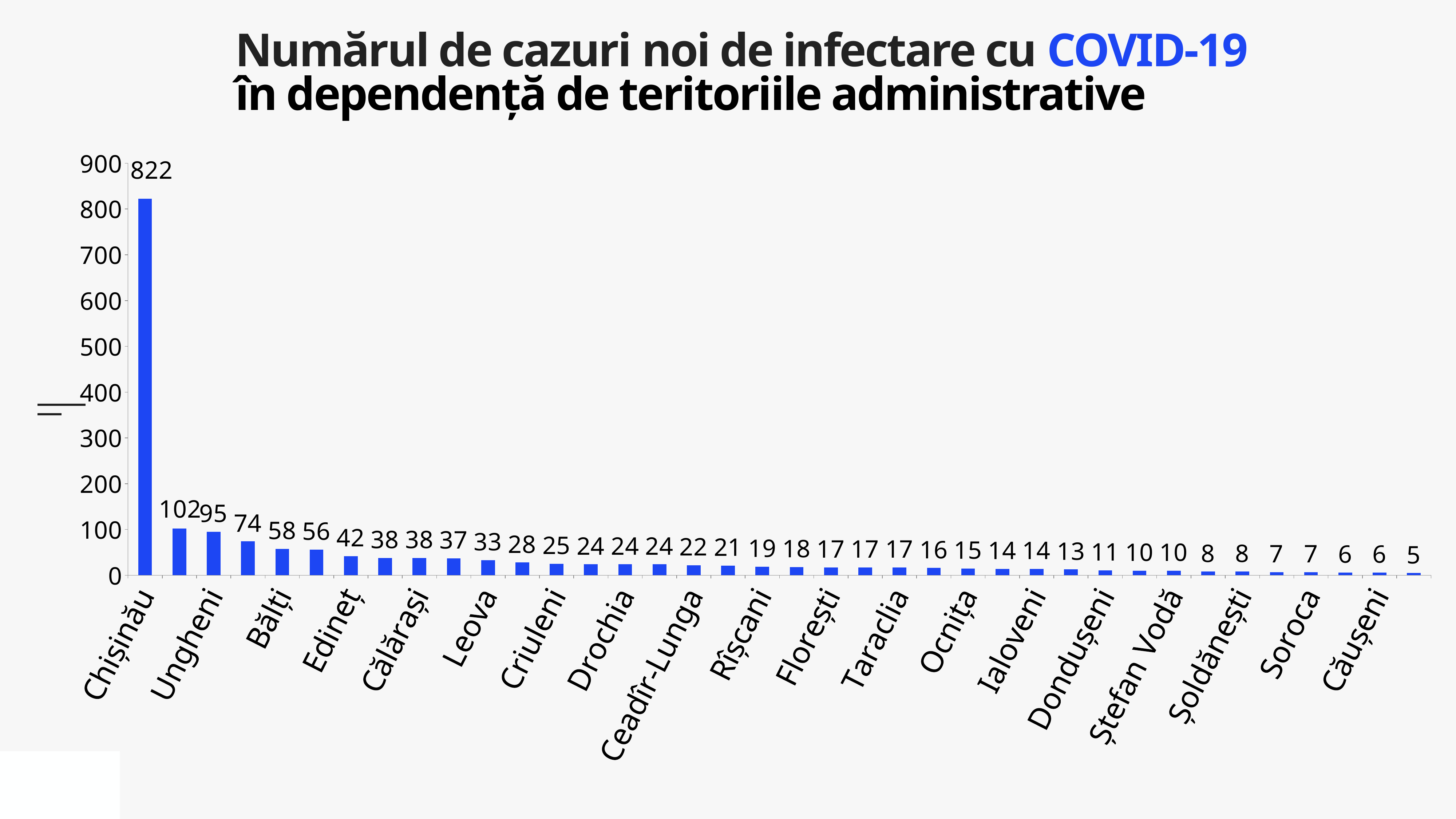
What is the maximum value on the vertical axis? 900 What is the lowest value shown on the chart? 5 What type of chart is shown on the slide? bar chart Is the value for Chișinău greater or less than 800? greater What is the highest value shown on the chart? 822 How many bars are plotted on the chart? 38 What colour are the bars in the chart? blue What is the number of new cases for Chișinău? 822 Which territory has the highest number of new COVID-19 cases? Chișinău What is the difference between the highest value (822) and the lowest value (5) on the chart? 817 Do the values rise or fall from left to right along the x axis? fall What is the second-highest value shown on the chart? 102